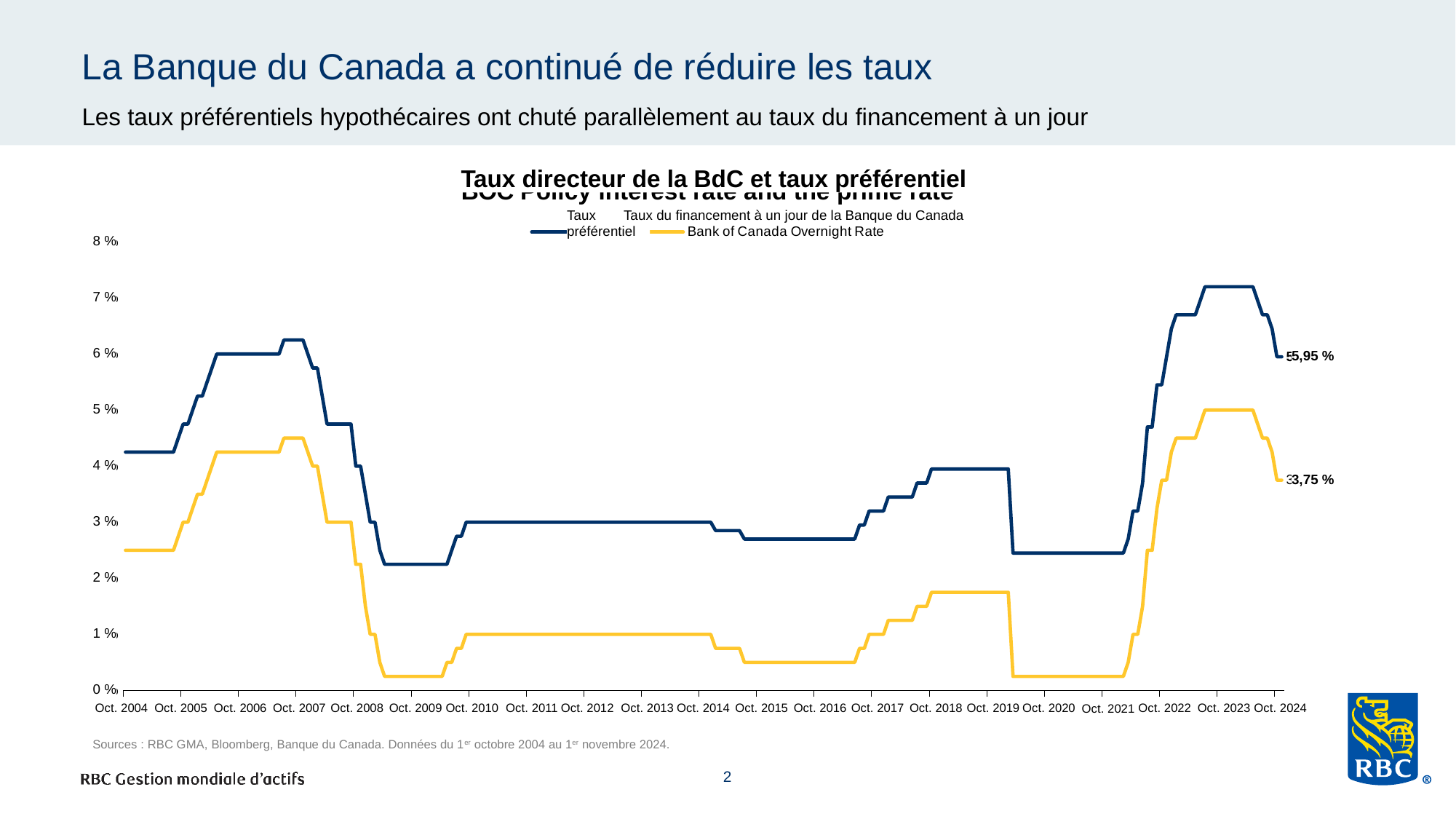
Is the value of the Bank of Canada Overnight Rate around Oct. 2020 greater or less than 1 %? less What colour is the line for the Taux préférentiel? dark blue Between Oct. 2023 and Oct. 2024, does the Bank of Canada Overnight Rate rise or fall? fall Is the value of the Taux préférentiel around Oct. 2023 greater or less than 6 %? greater Is the value of the Bank of Canada Overnight Rate around Oct. 2007 greater or less than 4 %? greater At the end of the series, which is higher: the Taux préférentiel or the Bank of Canada Overnight Rate? Taux préférentiel What kind of chart is shown on the slide? line chart What is the value of the Bank of Canada Overnight Rate at the end of the series (Oct. 2024)? 3,75 % What is the value of the Taux préférentiel at the end of the series (Oct. 2024)? 5,95 % What is the difference between the final Taux préférentiel value and the final Bank of Canada Overnight Rate value? 2,20 % How many series does the chart's legend list? 2